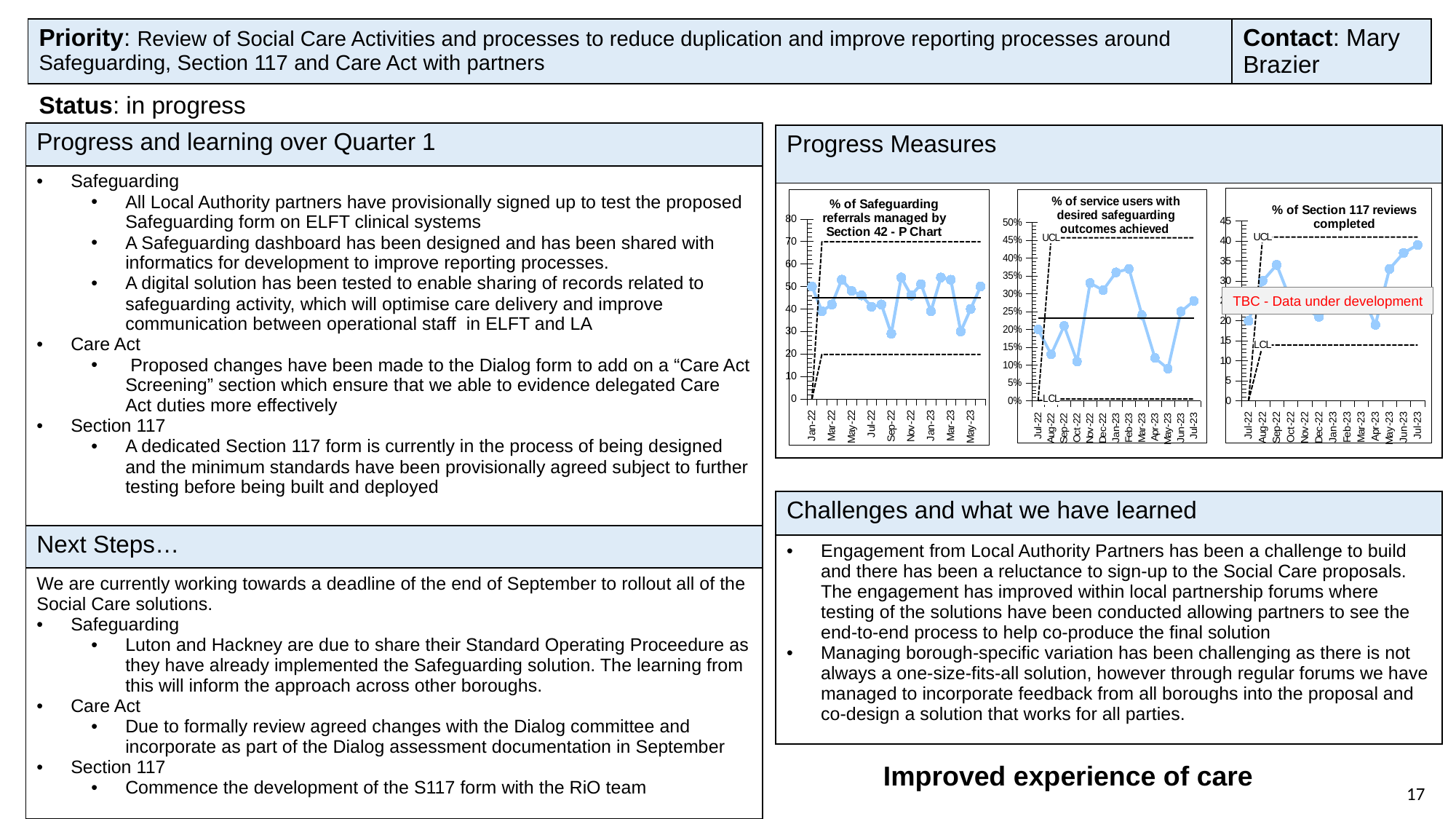
In the "% of service users with desired safeguarding outcomes achieved" chart, is the value for Nov-22 greater or less than 25%? greater In the "% of Safeguarding referrals managed by Section 42 - P Chart", is the value for Sep-22 greater or less than 40? less What note is overlaid on the "% of Section 117 reviews completed" chart? TBC - Data under development In the "% of Section 117 reviews completed" chart, is the value for Jul-22 greater or less than 25? less In the "% of service users with desired safeguarding outcomes achieved" chart, which is larger, the value for Jan-23 or the value for Apr-23? Jan-23 What is the title of the middle chart in the Progress Measures section? % of service users with desired safeguarding outcomes achieved In the "% of Section 117 reviews completed" chart, does the plotted value rise or fall overall from Jul-22 to Jul-23? rise What kind of chart is the "% of Safeguarding referrals managed by Section 42 - P Chart"? line chart How many charts are shown in the Progress Measures section? 3